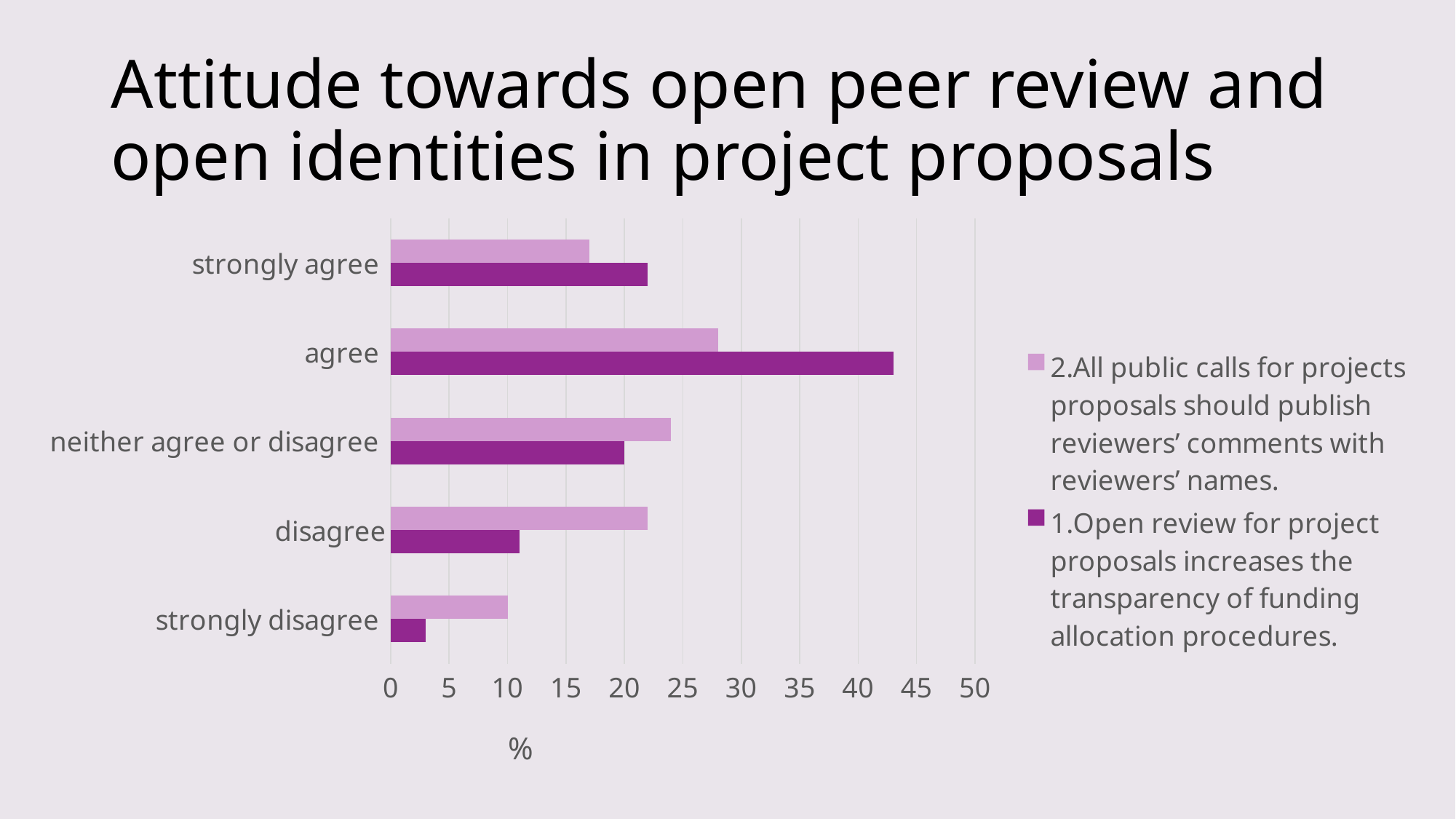
What unit is shown on the x axis label? % How many series does the legend list? 2 What kind of chart is shown on the slide? bar chart Which response category has the lowest value for series 2 (All public calls for projects proposals should publish reviewers' comments with reviewers' names)? strongly disagree Which response category has the highest value for series 1 (Open review for project proposals increases the transparency of funding allocation procedures)? agree Which response category has the lowest value for series 1 (Open review for project proposals increases the transparency of funding allocation procedures)? strongly disagree Is the value for 'strongly disagree' in series 1 (Open review increases transparency) greater or less than 5? less How many response categories are shown on the y axis? 5 Is the value for 'agree' in series 2 (All public calls should publish reviewers' comments with names) greater or less than 25? greater For 'disagree', which series has the larger value: series 1 (Open review increases transparency) or series 2 (All public calls should publish reviewers' comments with names)? series 2 (All public calls should publish reviewers' comments with names) Is the value for 'agree' in series 1 (Open review increases transparency) greater or less than 40? greater Which response category has the highest value for series 2 (All public calls for projects proposals should publish reviewers' comments with reviewers' names)? agree